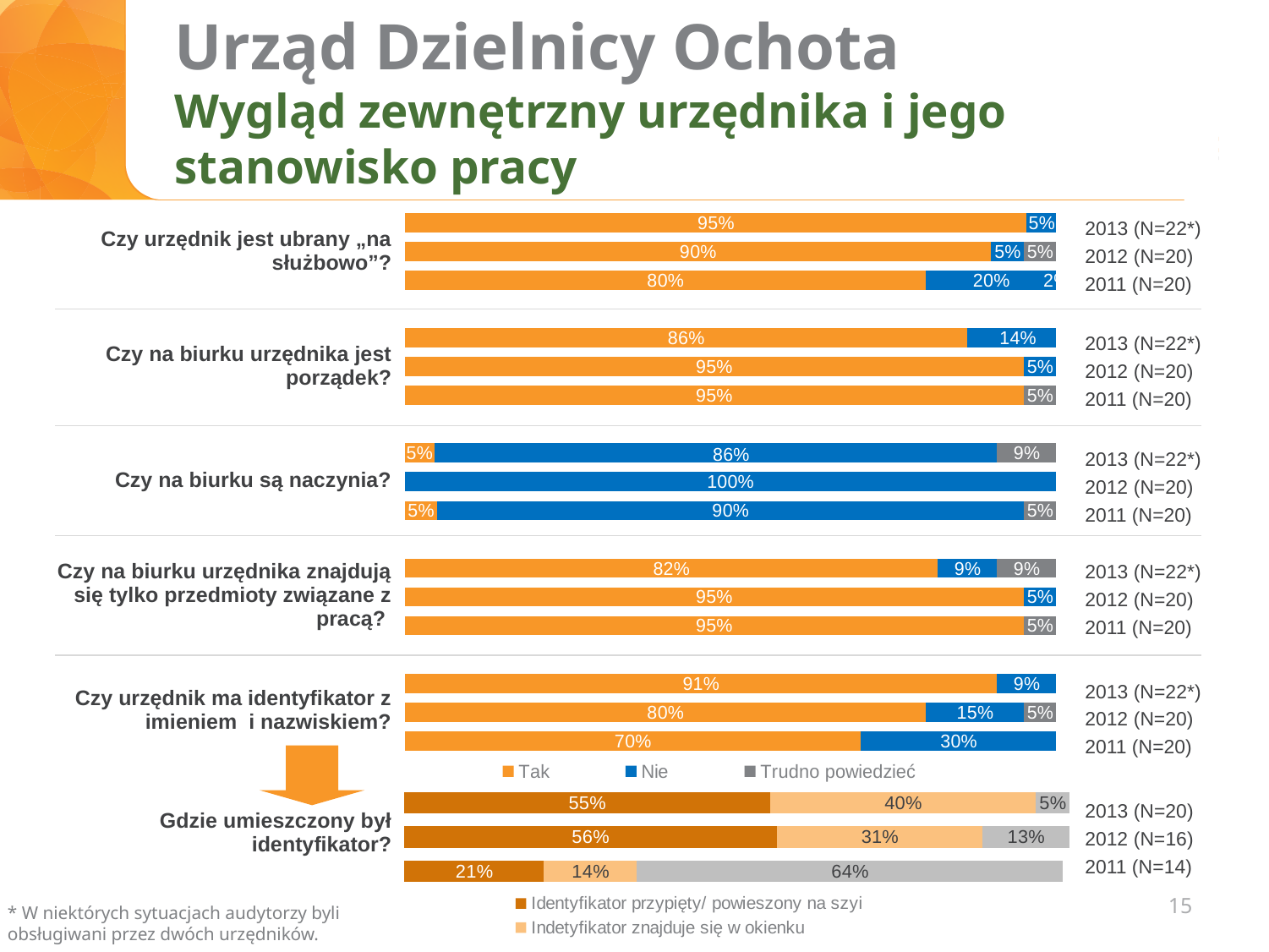
In the lower chart "Gdzie umieszczony był identyfikator?", which year had the lowest share for "Identyfikator przypięty/ powieszony na szyi"? 2011 In the upper chart, by how many percentage points did the "Tak" share for "Czy urzędnik ma identyfikator z imieniem i nazwiskiem?" change between 2011 and 2013? 21 percentage points How many years (bars) are shown in the lower chart "Gdzie umieszczony był identyfikator?"? 3 What type of chart is used on this slide? Bar chart In the lower chart "Gdzie umieszczony był identyfikator?", what percentage was "Indetyfikator znajduje się w okienku" in 2013? 40% In the lower chart "Gdzie umieszczony był identyfikator?", what percentage was "Identyfikator przypięty/ powieszony na szyi" in 2011? 21% In the upper chart, what percentage answered "Nie" to "Czy na biurku są naczynia?" in 2012? 100% In the upper chart, what percentage answered "Tak" to "Czy na biurku urzędnika znajdują się tylko przedmioty związane z pracą?" in 2013? 82% In the upper chart, what percentage answered "Nie" to "Czy urzędnik ma identyfikator z imieniem i nazwiskiem?" in 2011? 30% In the upper chart, what percentage answered "Tak" to "Czy urzędnik jest ubrany „na służbowo”?" in 2013? 95% How many series does the legend of the upper chart list? 3 In the upper chart, for "Czy na biurku urzędnika jest porządek?", which year had the larger "Tak" share: 2013 or 2012? 2012